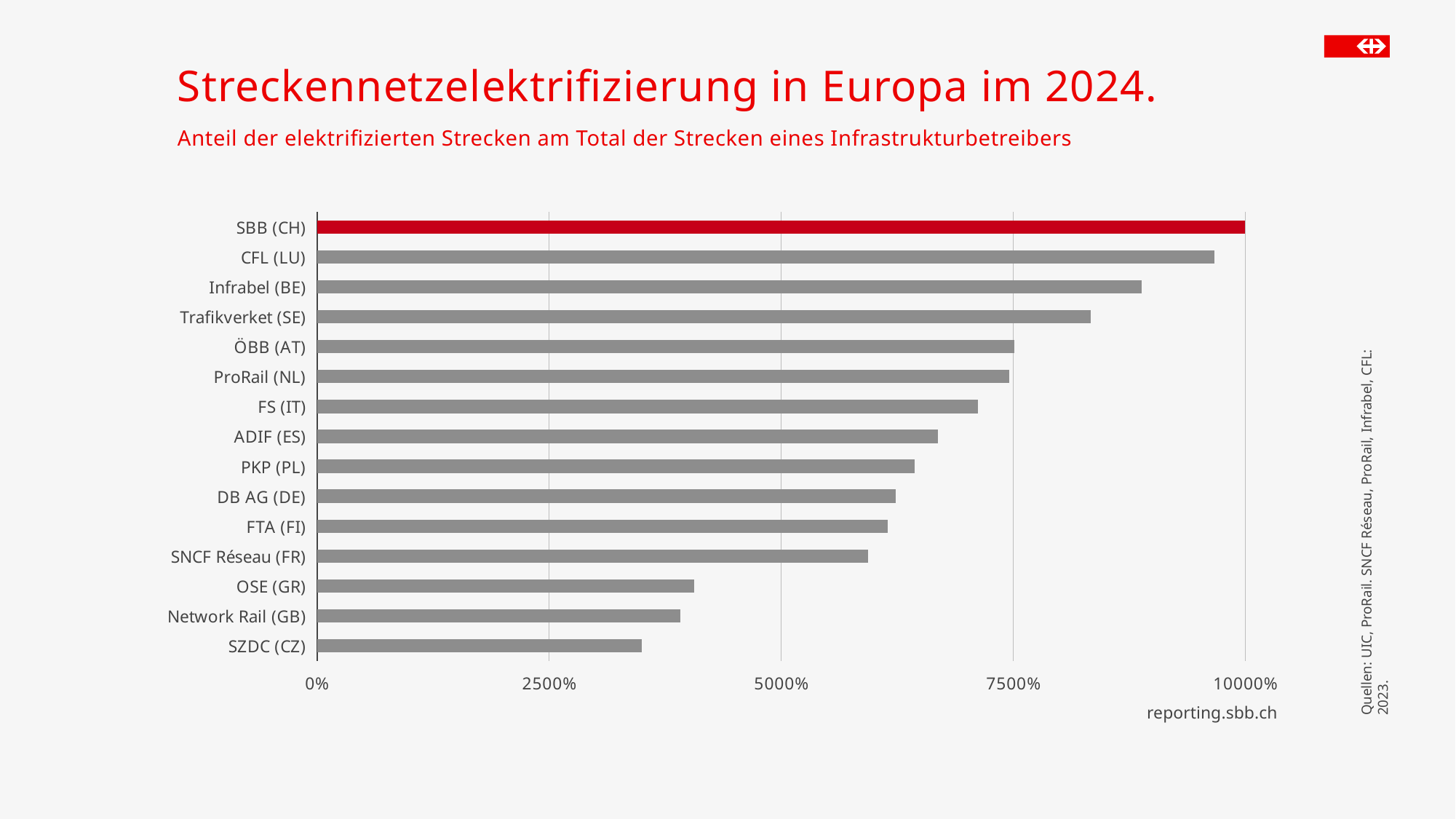
Is the value for CFL (LU) greater or less than 7500%? greater How many infrastructure operators are listed in the chart? 15 Which operator has the lowest share of electrified lines? SZDC (CZ) Which has the larger value, ADIF (ES) or SNCF Réseau (FR)? ADIF (ES) What kind of chart is shown on the slide? bar chart Which bar in the chart is coloured red rather than grey? SBB (CH) Is the value for FS (IT) greater or less than 7500%? less Which has the larger value, CFL (LU) or Infrabel (BE)? CFL (LU) Is the value for SZDC (CZ) greater or less than 2500%? greater Which operator has the highest share of electrified lines? SBB (CH)